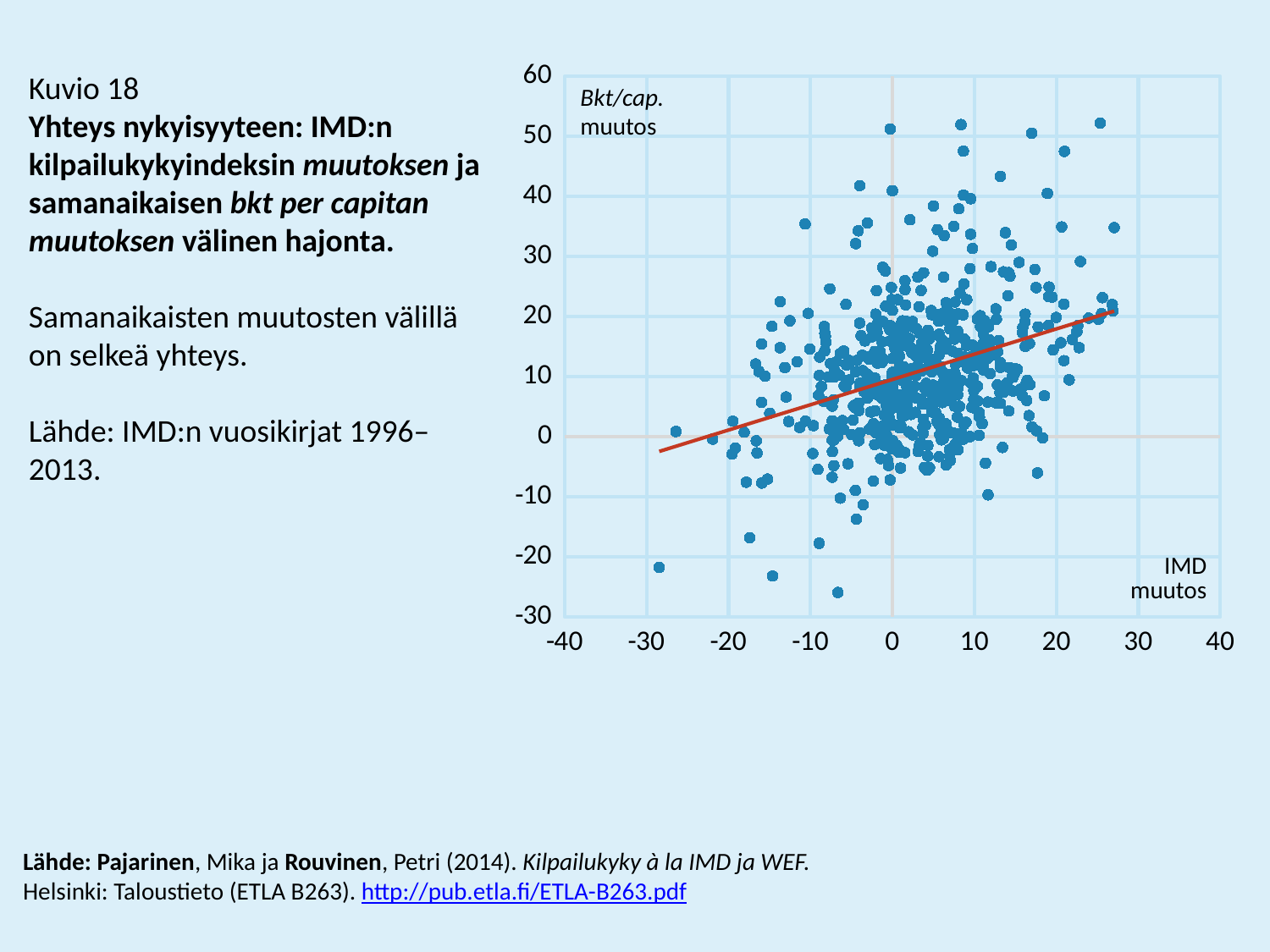
What is the highest tick value shown on the vertical axis of the chart? 60 What is the label of the horizontal axis of the chart? IMD muutos What is the lowest tick value shown on the vertical axis of the chart? -30 Does the red trend line in the chart rise or fall as the IMD muutos value increases along the x axis? rise What kind of chart is shown on the slide? scatter plot What is the lowest tick value shown on the horizontal axis of the chart? -40 What is the highest tick value shown on the horizontal axis of the chart? 40 Is the value of the red trend line at IMD muutos = 20 greater or less than 10? greater What is the figure number given for the chart on the slide? Kuvio 18 Is the value of the red trend line at IMD muutos = 0 greater or less than 20? less What is the label of the vertical axis of the chart? Bkt/cap. muutos Is the relationship between IMD muutos and Bkt/cap. muutos shown by the trend line positive or negative? positive